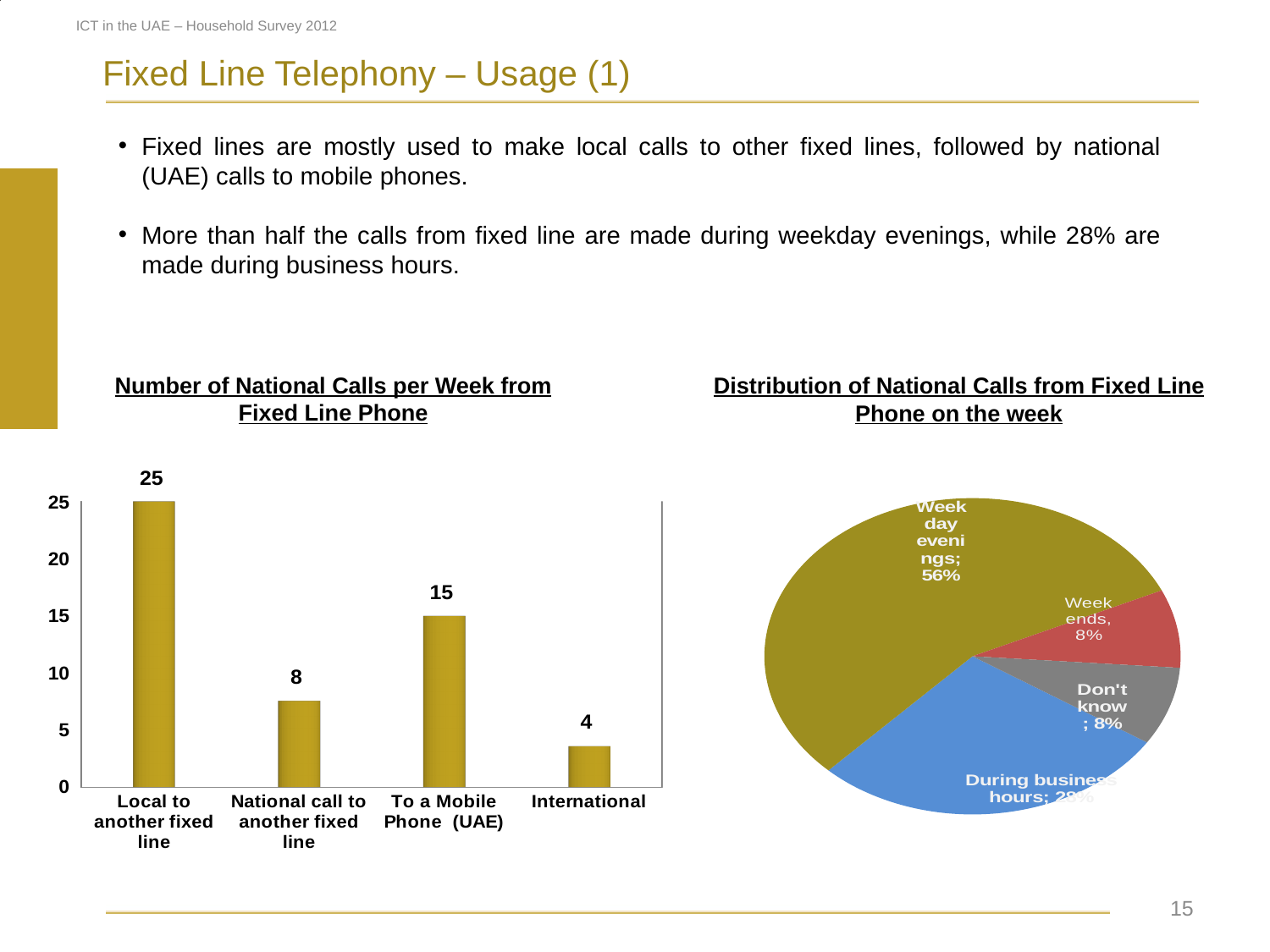
In the 'Number of National Calls per Week from Fixed Line Phone' chart, which category has the highest value? Local to another fixed line In the 'Number of National Calls per Week from Fixed Line Phone' chart, which is larger: 'National call to another fixed line' or 'To a Mobile Phone (UAE)'? To a Mobile Phone (UAE) In the 'Distribution of National Calls from Fixed Line Phone on the week' pie chart, what share is 'Week ends'? 8% In the 'Number of National Calls per Week from Fixed Line Phone' chart, what is the value for 'To a Mobile Phone (UAE)'? 15 What type of chart is 'Number of National Calls per Week from Fixed Line Phone'? Bar chart In the 'Number of National Calls per Week from Fixed Line Phone' chart, what is the value for 'Local to another fixed line'? 25 In the 'Number of National Calls per Week from Fixed Line Phone' chart, which category has the lowest value? International In the 'Number of National Calls per Week from Fixed Line Phone' chart, what is the difference between 'Local to another fixed line' and 'National call to another fixed line'? 17 What type of chart is 'Distribution of National Calls from Fixed Line Phone on the week'? Pie chart In the 'Number of National Calls per Week from Fixed Line Phone' chart, what is the value for 'International'? 4 How many categories are shown in the 'Number of National Calls per Week from Fixed Line Phone' chart? 4 In the 'Distribution of National Calls from Fixed Line Phone on the week' pie chart, what share is 'Week day evenings'? 56%